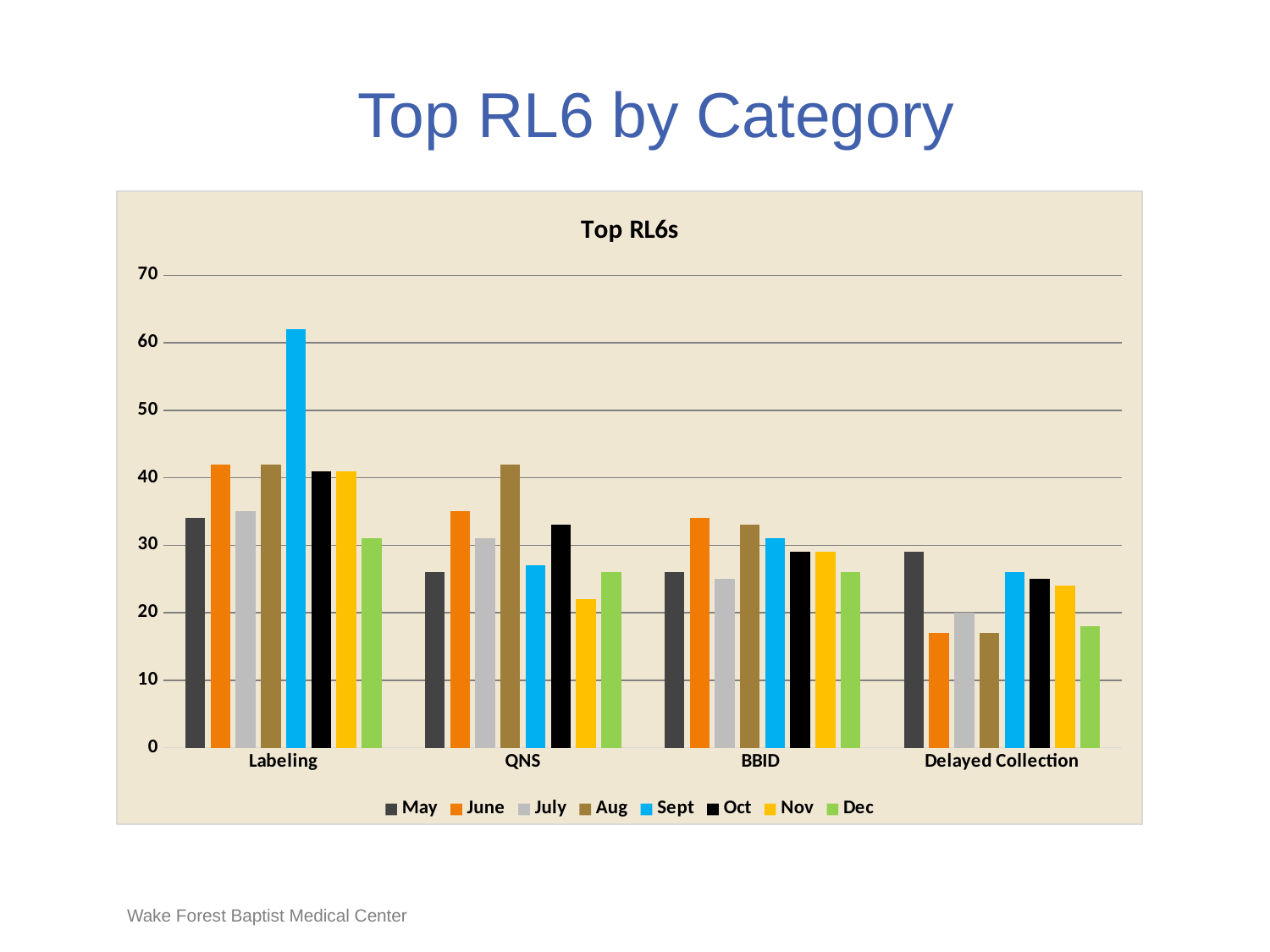
Is the value for Sept in the Labeling category greater or less than 50? greater Which month has the highest value for QNS? Aug What is the title of the chart? Top RL6s Which is larger: the Sept value for Labeling or the Sept value for QNS? Labeling Which is larger for Delayed Collection: the May value or the Dec value? May Is the value for Nov in the QNS category greater or less than 30? less How many series does the legend list? 8 Is the value for June in the Delayed Collection category greater or less than 20? less Which month has the lowest value for QNS? Nov How many categories are shown on the x axis? 4 Which month has the highest value for Labeling? Sept What kind of chart is shown on the slide? bar chart